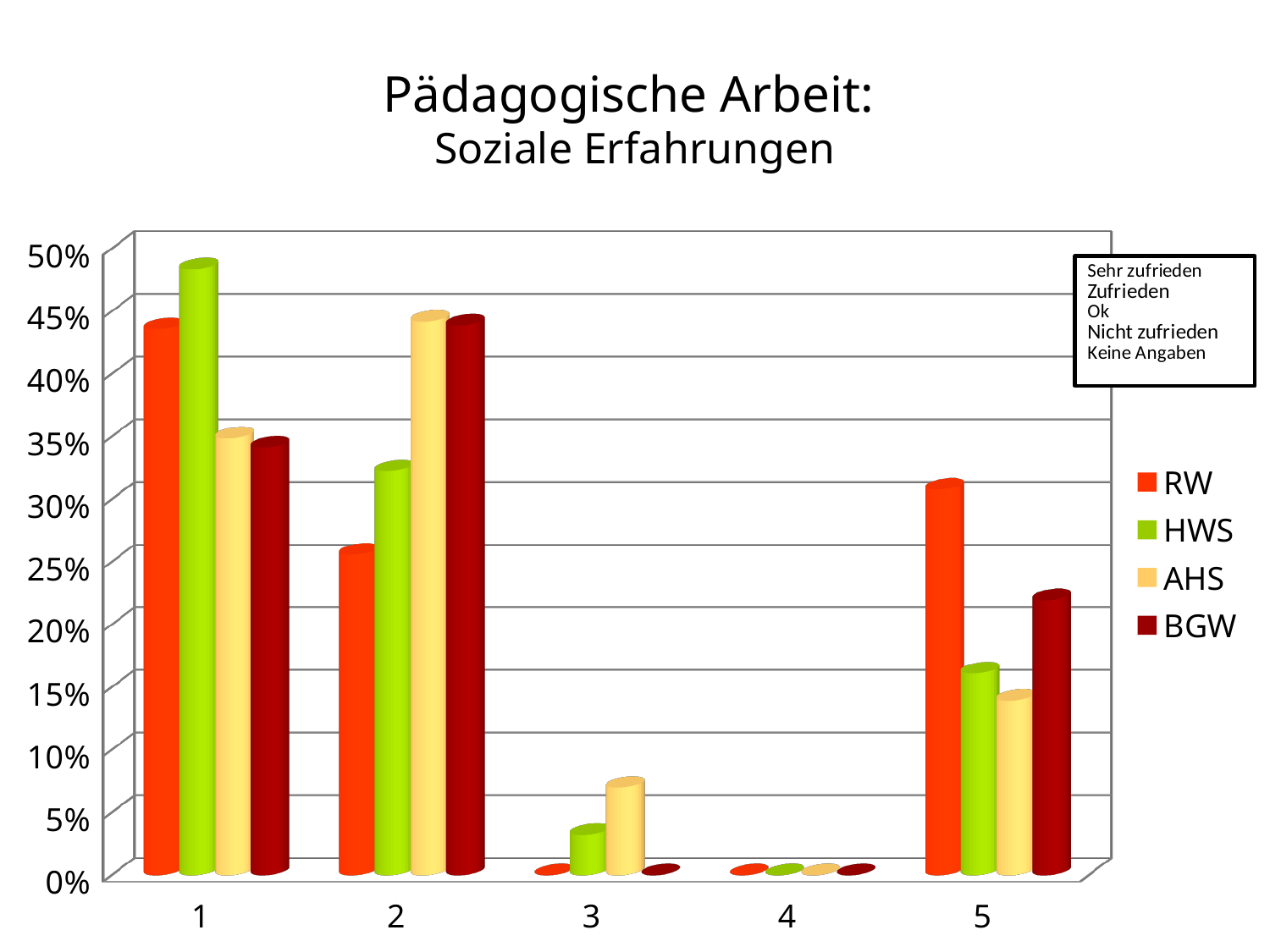
Is the value for BGW in category 5 greater or less than 20%? greater Which series has the lowest value in category 2? RW What is the value for RW in category 4? 0% How many series does the legend list? 4 What kind of chart is shown on the slide? bar chart Which series has the highest value in category 1? HWS Which is larger in category 1, RW or HWS? HWS Which series has the highest value in category 5? RW What is the title of the chart? Pädagogische Arbeit: Soziale Erfahrungen Is the value for RW in category 1 greater or less than 40%? greater How many categories are shown on the x axis? 5